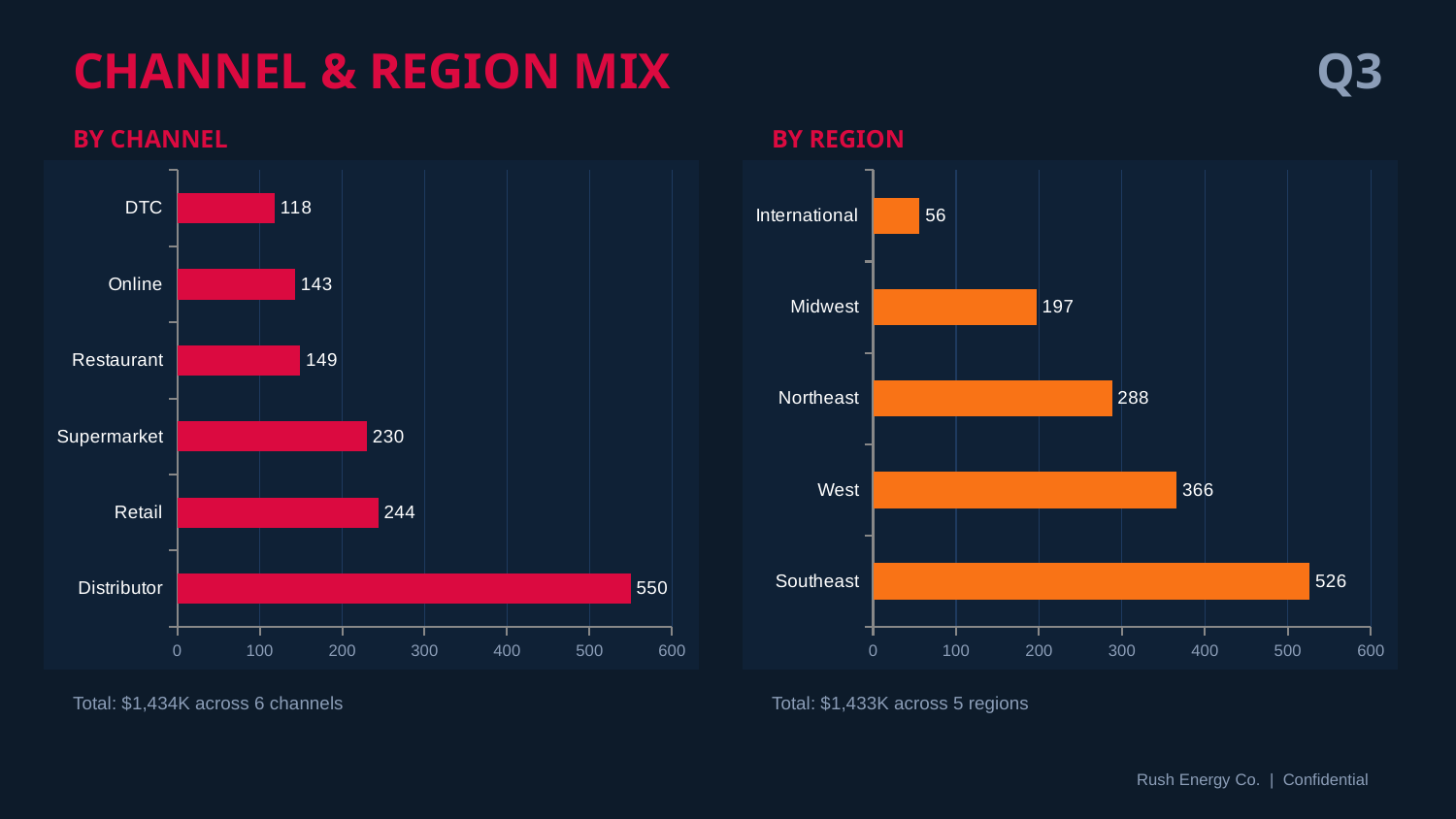
In the BY CHANNEL chart, which channel has the highest value? Distributor In the BY CHANNEL chart, which is larger, Retail or Supermarket? Retail In the BY CHANNEL chart, what is the difference between Retail and Online? 101 What kind of chart is the BY REGION chart? Bar chart In the BY CHANNEL chart, what is the value for Supermarket? 230 In the BY REGION chart, what is the difference between Southeast and West? 160 How many channels are shown in the BY CHANNEL chart? 6 In the BY REGION chart, is the value for Midwest greater or less than 300? less How many regions are shown in the BY REGION chart? 5 In the BY REGION chart, which region has the lowest value? International In the BY CHANNEL chart, what is the value for DTC? 118 In the BY REGION chart, what is the value for Northeast? 288